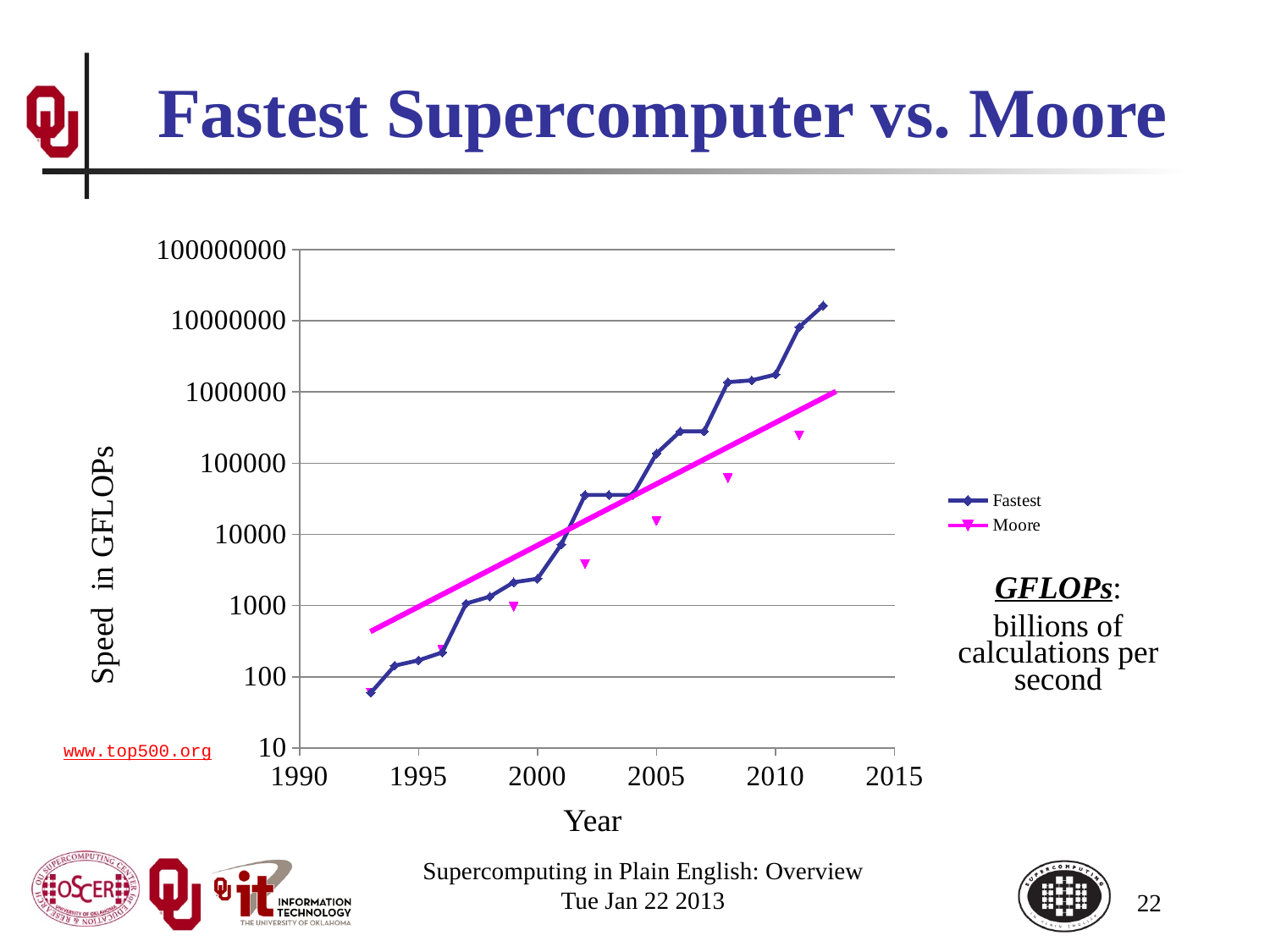
Is the Fastest value for 2010 greater or less than 1000000? greater What kind of chart is shown on the slide? line chart Is the Moore value for 2011 greater or less than 1000000? less Is the Fastest value for 1993 greater or less than 100? less What are the two series named in the legend? Fastest and Moore How many series does the legend list? 2 In 2011, which series has the larger value, Fastest or Moore? Fastest Does the Fastest series rise or fall as the year increases? rise What is the label on the y axis of the chart? Speed in GFLOPs In which year does the Fastest series reach its highest value? 2012